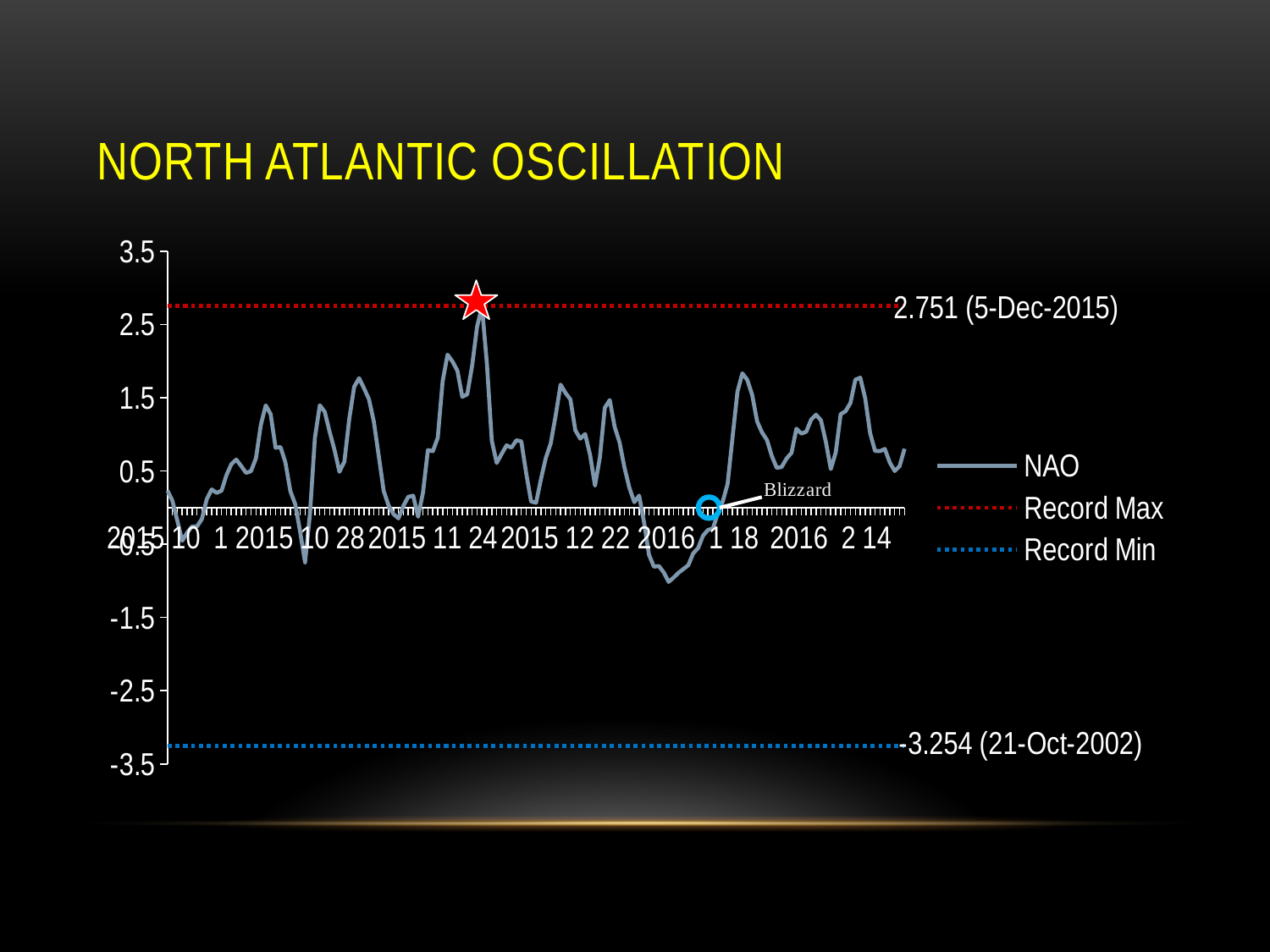
Is the lowest NAO value on the line greater or less than -1.5? greater What is the title of the chart on the slide? North Atlantic Oscillation What is the difference between the Record Max value and the Record Min value? 6.005 What is the value of the Record Max line? 2.751 What is the value of the Record Min line? -3.254 Is the NAO value at the point labelled Blizzard greater or less than 0.5? less On what date was the Record Min of -3.254 set? 21-Oct-2002 Is the peak NAO value marked with the star greater or less than 2.5? greater How many series does the legend list? 3 What kind of chart is shown on the slide? Line chart What colour is the Record Max line in the chart? Red On what date was the Record Max of 2.751 set? 5-Dec-2015